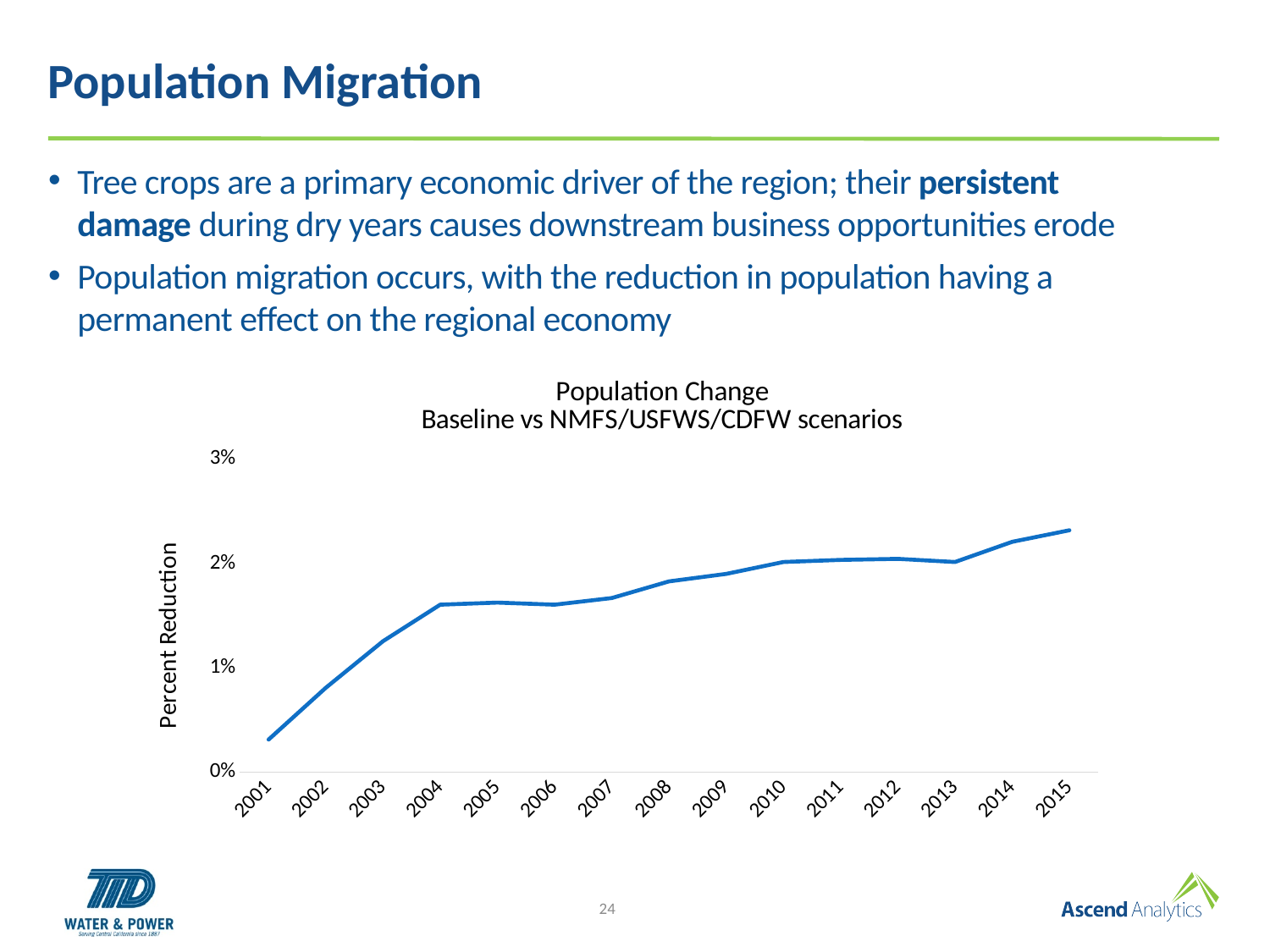
What is the label on the vertical axis of the chart? Percent Reduction Is the value for 2003 greater or less than 1%? greater What is the title of the chart? Population Change Baseline vs NMFS/USFWS/CDFW scenarios Is the value for 2004 greater or less than 2%? less Is the value for 2001 greater or less than 1%? less Which year has the lowest percent reduction? 2001 Which is larger, the value for 2002 or the value for 2008? 2008 How many years are plotted along the x axis of the chart? 15 What kind of chart is shown on the slide? line chart Do the values generally rise or fall from 2001 to 2015? rise Which year has the highest percent reduction? 2015